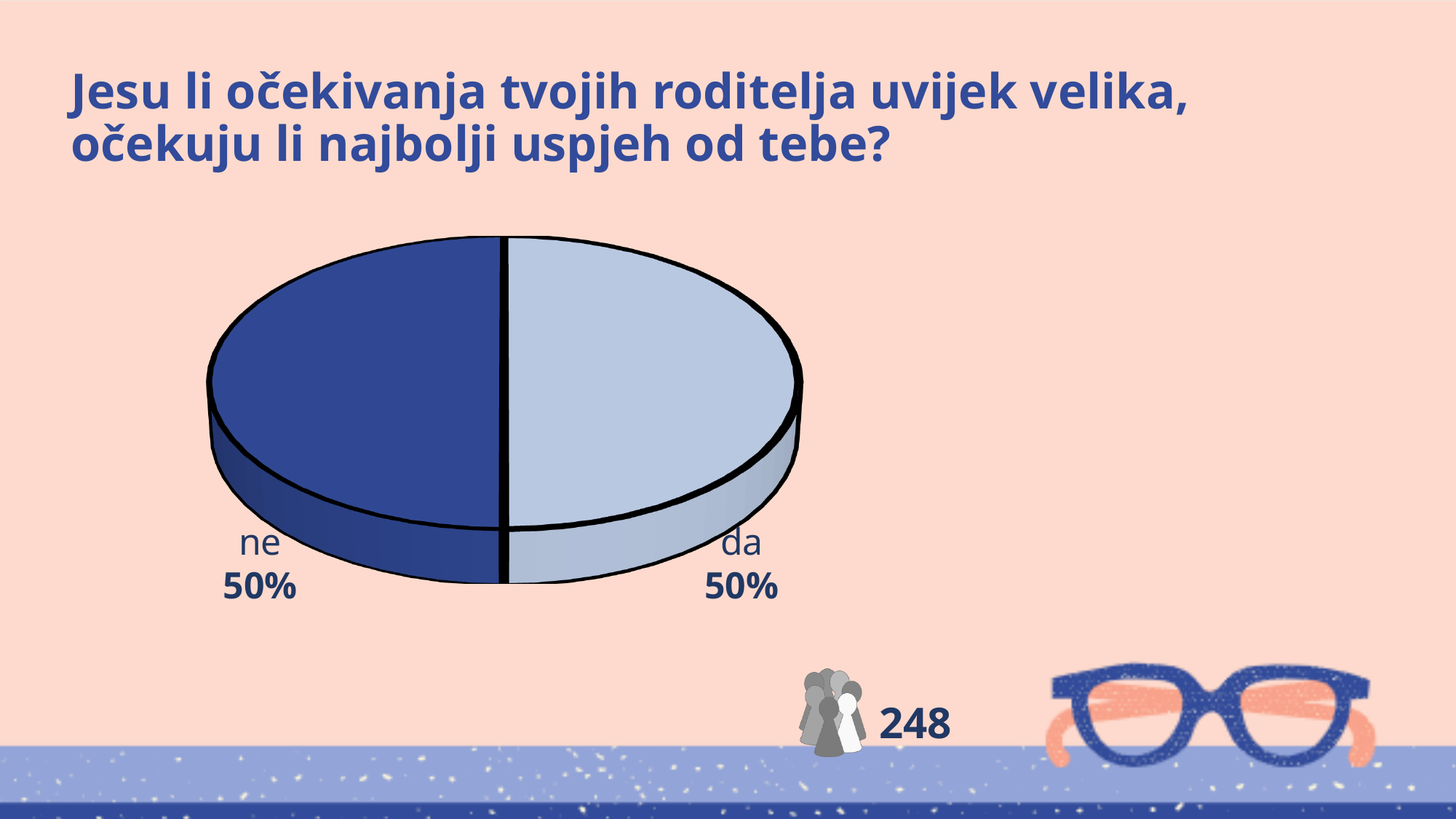
Is the "da" slice larger or smaller than the "ne" slice, or are they equal? equal Which slice of the pie chart is coloured dark blue? ne What kind of chart is shown on the slide? pie chart What share of the pie does the "ne" slice take? 50% How many slices does the pie chart have? 2 What percentage of the pie chart is labelled "da"? 50% What percentage of the pie chart is labelled "ne"? 50% What is the difference between the "da" share and the "ne" share in the pie chart? 0% What is the total of the two percentages shown on the pie chart? 100% What are the labels of the two slices in the pie chart? ne and da